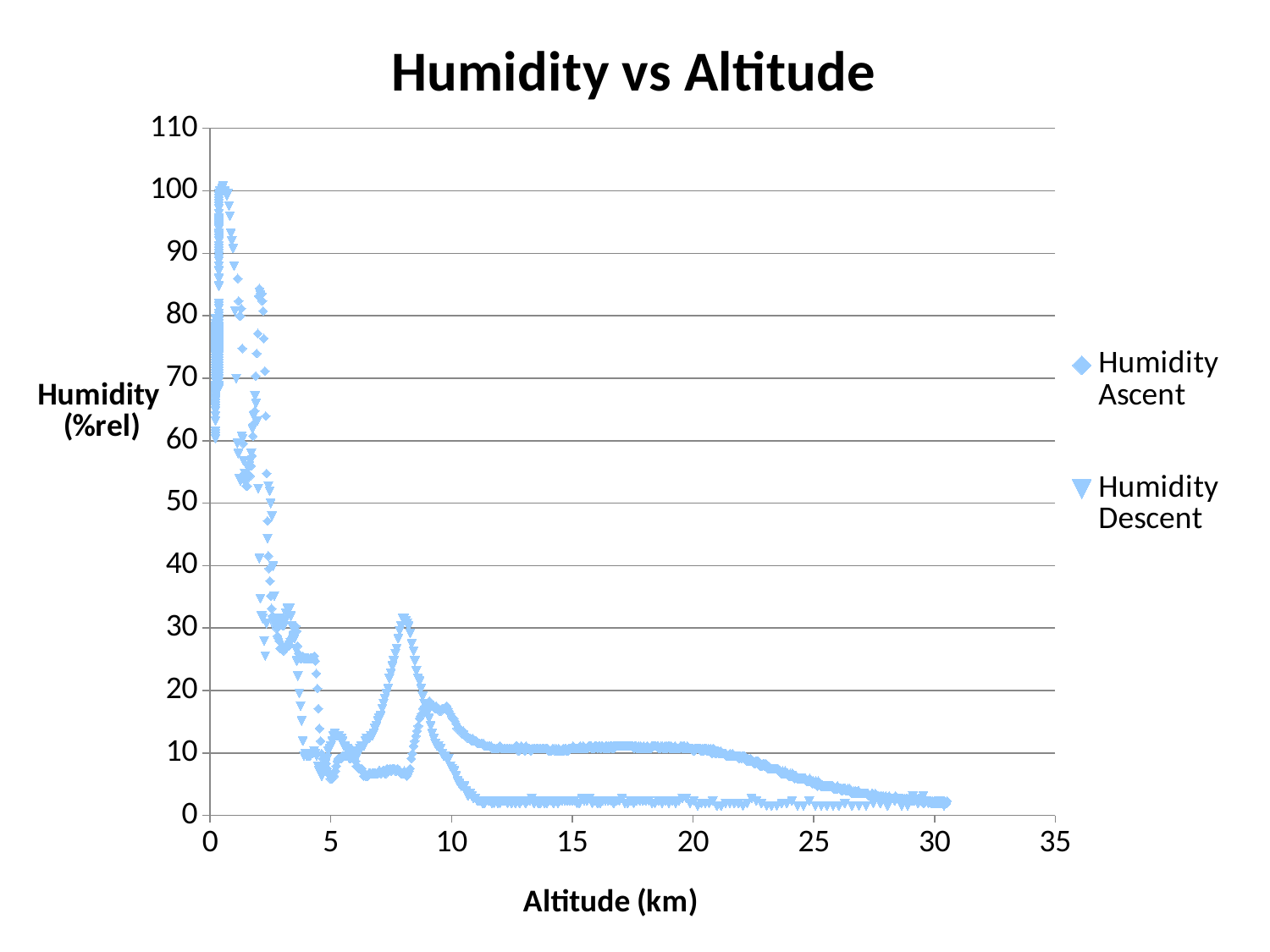
Is the Humidity Descent value at an altitude of 8 km greater or less than 20? greater What kind of chart is shown on the slide? scatter chart Is the Humidity Ascent value at an altitude of 15 km greater or less than 5? greater Overall, does humidity rise or fall as altitude increases along the x axis? fall What is the highest tick value shown on the x axis? 35 What is the label of the x axis? Altitude (km) Is the Humidity Descent value at an altitude of 15 km greater or less than 5? less What is the title of the chart? Humidity vs Altitude How many series does the legend list? 2 At an altitude of 15 km, which series has the higher humidity, Humidity Ascent or Humidity Descent? Humidity Ascent